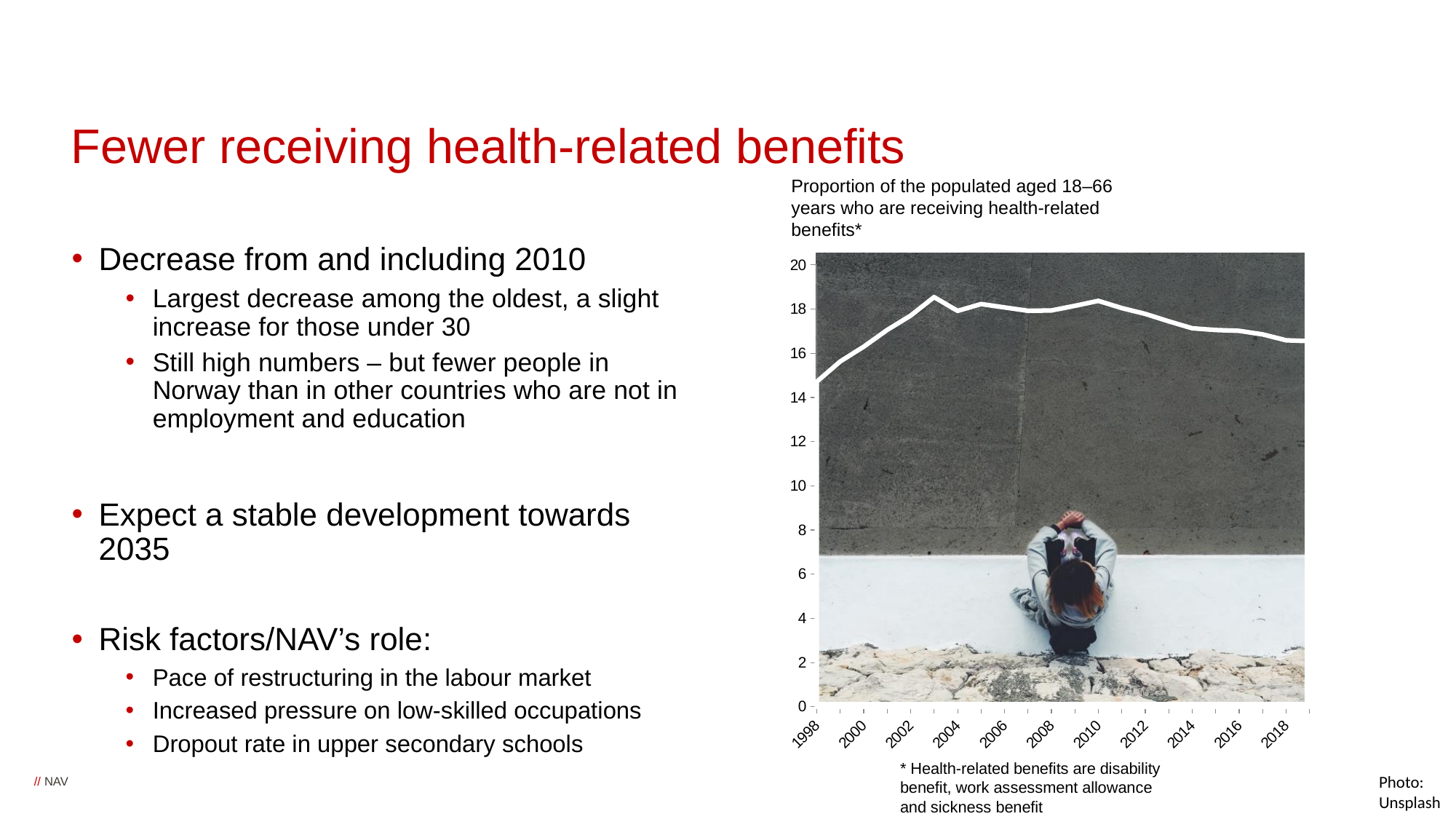
Is the value for 1998 greater or less than 16? less Is the value for 2003 greater or less than 18? greater Which is larger, the value for 2003 or the value for 2014? 2003 What is the title of the chart? Proportion of the populated aged 18–66 years who are receiving health-related benefits* What kind of chart is shown on the slide? line chart Is the value for 2018 greater or less than 18? less Do the values rise or fall from 1998 to 2003? rise Which year has the lowest value on the chart? 1998 Which is larger, the value for 1998 or the value for 2018? 2018 Do the values rise or fall from 2010 to 2018? fall